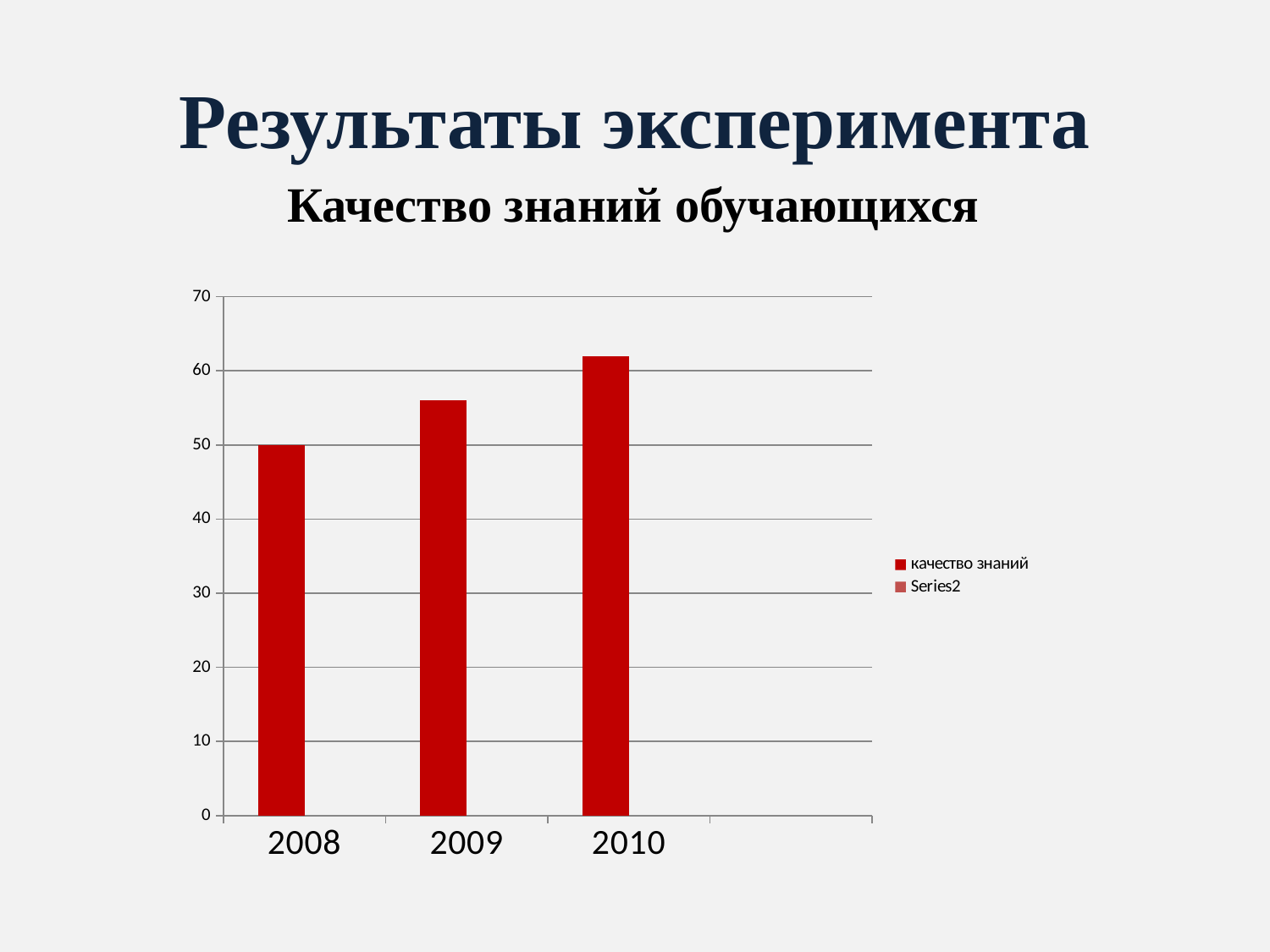
Which year has the highest bar in the chart? 2010 Is the value for 2010 greater or less than 60? greater What is the name of the first series listed in the chart legend? качество знаний Do the values rise or fall from 2008 to 2010? rise Which year has the lowest bar in the chart? 2008 What kind of chart is shown on the slide? bar chart How many series does the chart legend list? 2 How many years are shown on the x axis of the chart? 3 Is the value for 2009 greater or less than 60? less Which year has the larger value, 2009 or 2010? 2010 What is the value for 2008 in the chart? 50 Is the value for 2009 greater or less than 50? greater